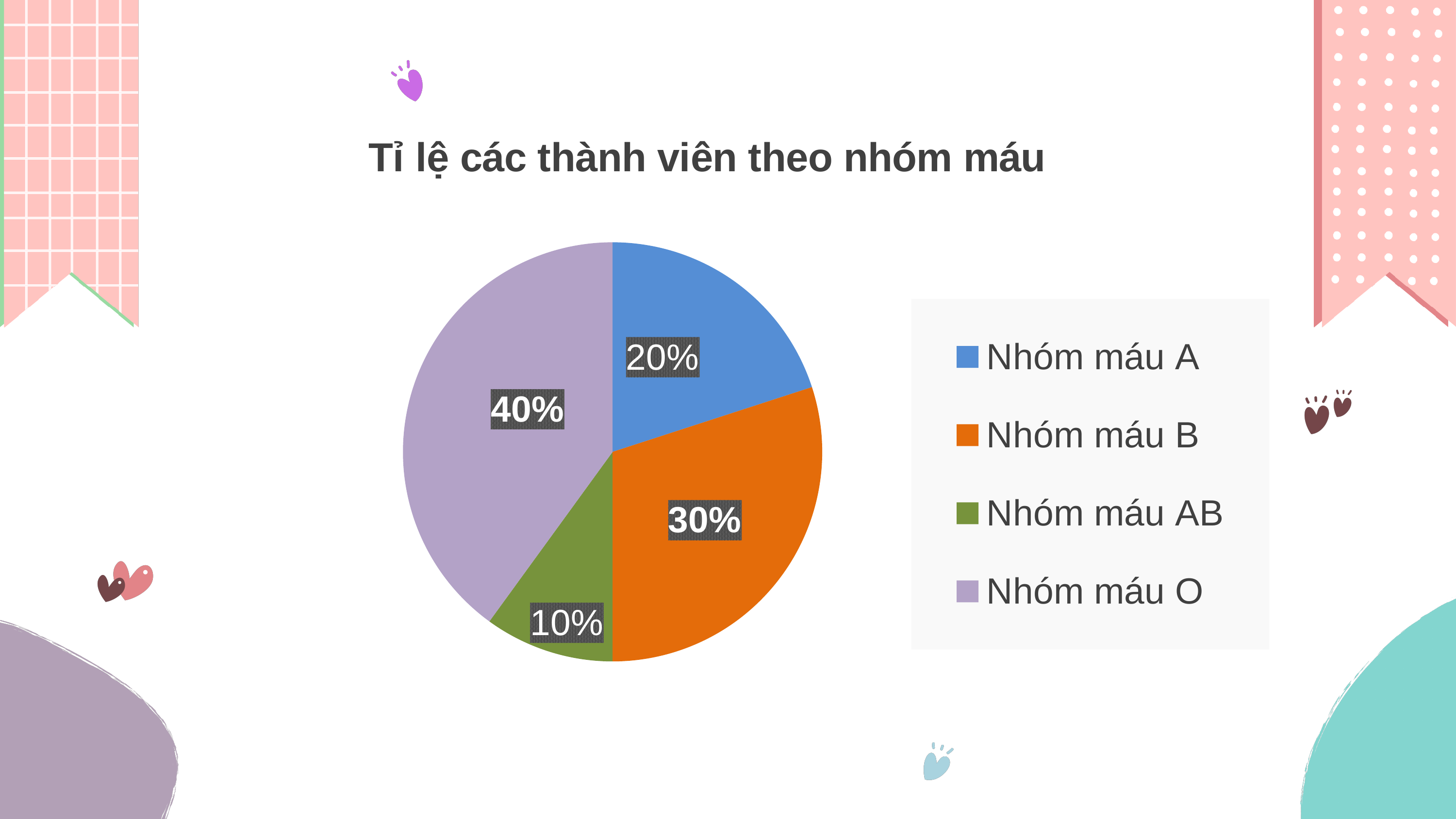
How many blood groups are shown in the pie chart? 4 What is the difference in percentage points between Nhóm máu O and Nhóm máu A? 20% What percentage of members have blood group O (Nhóm máu O)? 40% Which blood group has the smallest share of members? Nhóm máu AB What colour represents Nhóm máu B in the pie chart? Orange What percentage of members have blood group AB (Nhóm máu AB)? 10% What type of chart is shown on the slide? Pie chart What is the title of the chart? Tỉ lệ các thành viên theo nhóm máu Which has a larger share, Nhóm máu B or Nhóm máu A? Nhóm máu B What percentage of members have blood group B (Nhóm máu B)? 30% Which blood group has the largest share of members? Nhóm máu O What percentage of members have blood group A (Nhóm máu A)? 20%